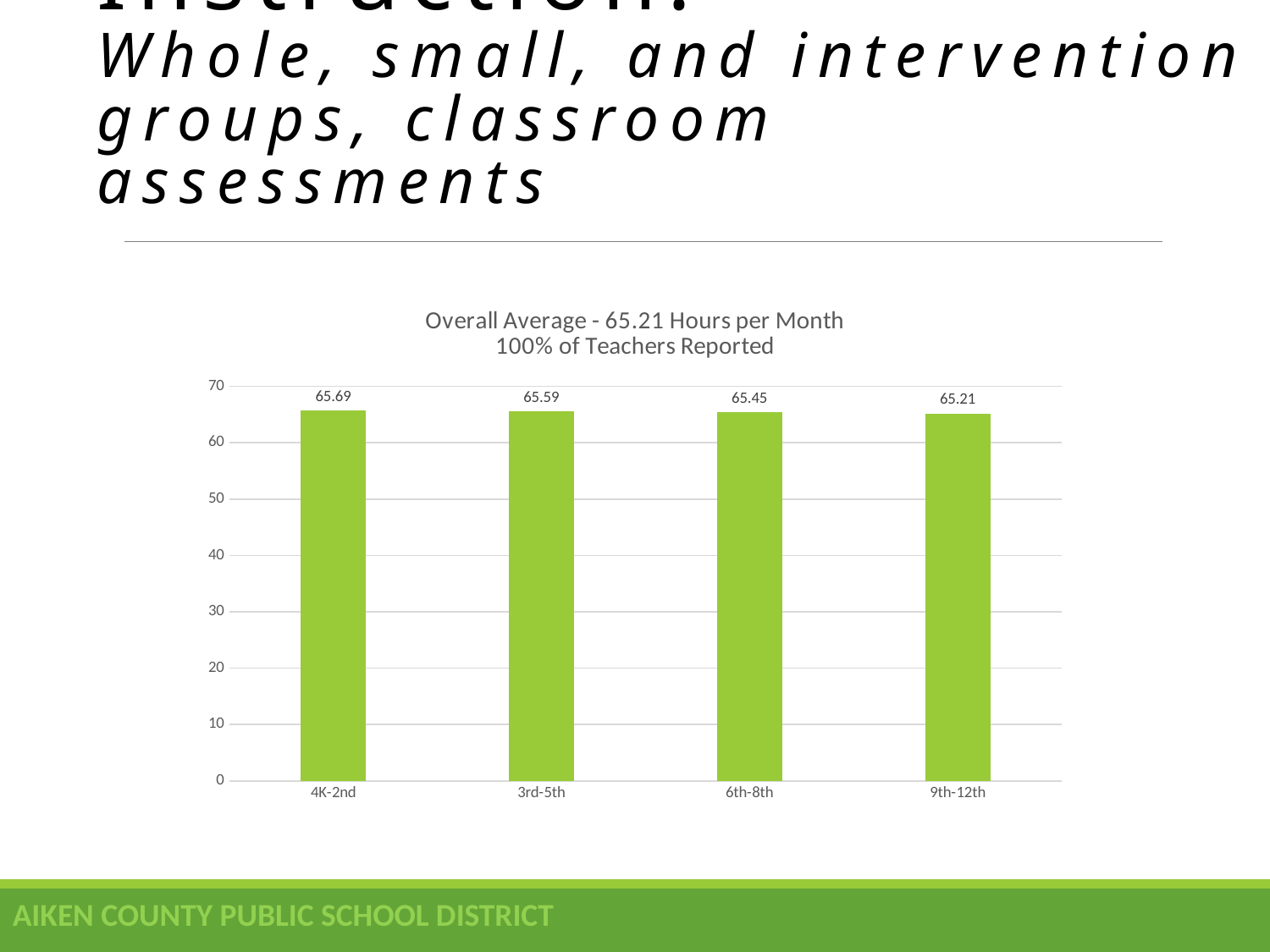
What kind of chart is shown on the slide? bar chart Which is larger, the value for 3rd-5th or the value for 6th-8th? 3rd-5th How many grade bands are shown on the chart? 4 What is the value for 3rd-5th? 65.59 Which grade band has the highest value? 4K-2nd Is the value for 6th-8th greater or less than 60? greater What is the value for 6th-8th? 65.45 Do the values rise or fall from 4K-2nd to 9th-12th? fall Which grade band has the lowest value? 9th-12th What is the value for 9th-12th? 65.21 What is the value for 4K-2nd? 65.69 What is the difference between the values for 4K-2nd and 9th-12th? 0.48